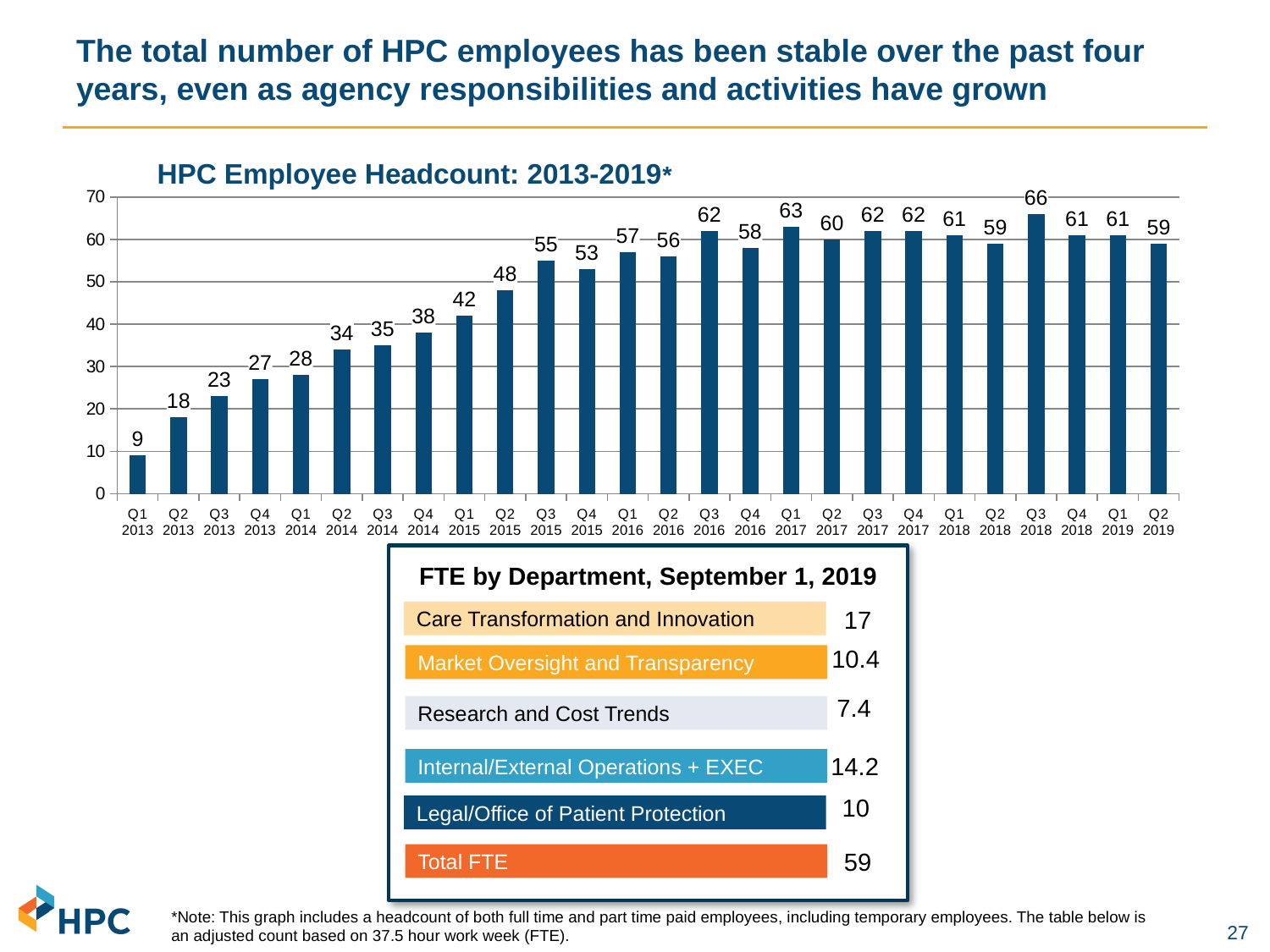
Which quarter has the highest headcount? Q3 2018 Which quarter has the lowest headcount? Q1 2013 What kind of chart is used to show the HPC employee headcount? bar chart What is the headcount for Q3 2018? 66 What is the headcount for Q2 2019? 59 Which has a larger headcount, Q3 2015 or Q4 2015? Q3 2015 What is the difference in headcount between Q1 2013 and Q1 2014? 19 What is the title of the chart? HPC Employee Headcount: 2013-2019* What is the headcount for Q1 2013? 9 How many quarters are shown on the chart? 26 What is the difference in headcount between Q3 2018 and Q2 2019? 7 Is the headcount for Q2 2015 greater or less than 50? less